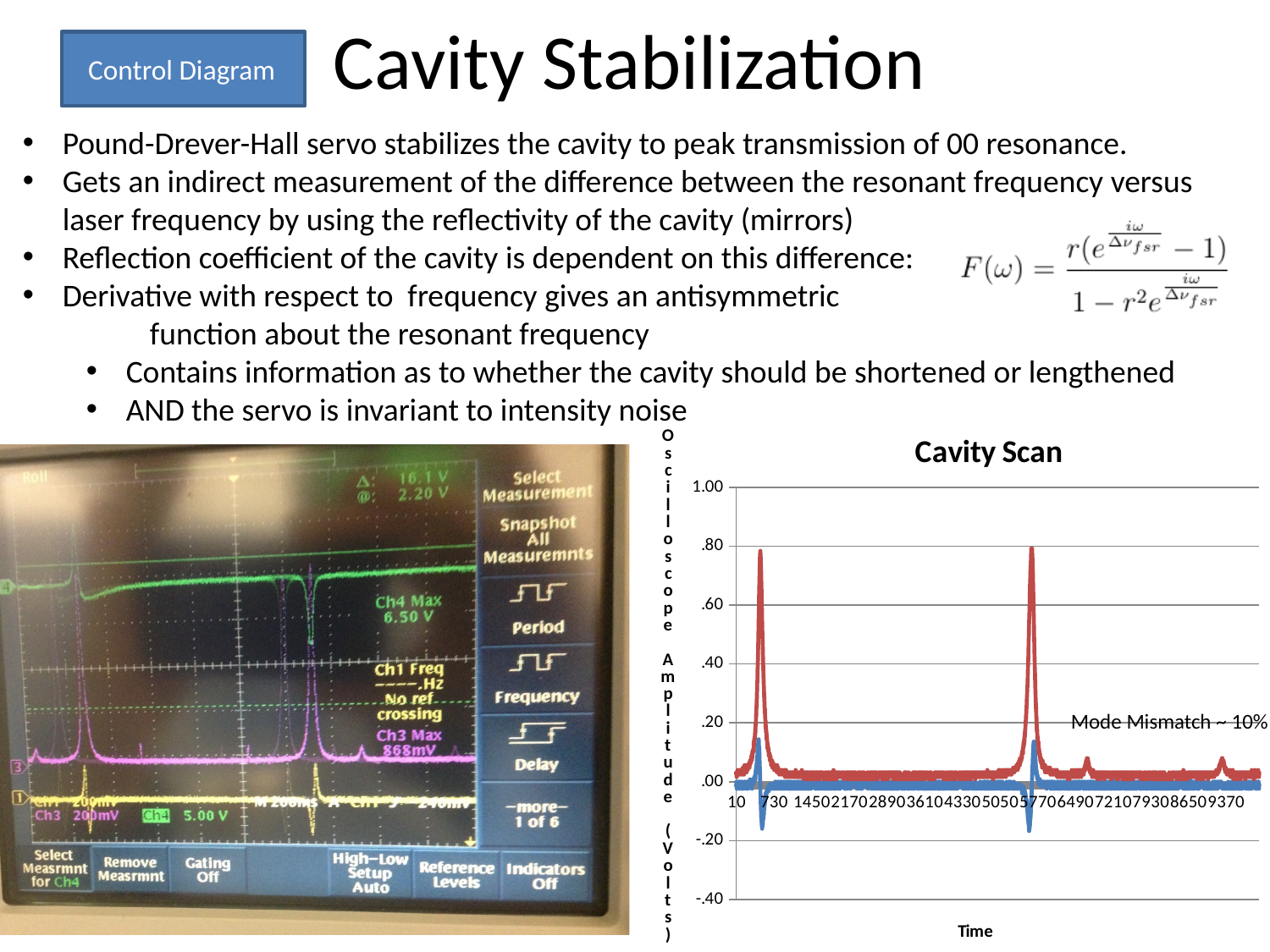
What type of chart is the "Cavity Scan" chart? line chart In the "Cavity Scan" chart, is the highest value reached by the blue line greater or less than .40? less In the "Cavity Scan" chart, is the lowest value reached by the blue line greater or less than .00? less In the "Cavity Scan" chart, what is the label of the x axis? Time How many data series (lines) are plotted in the "Cavity Scan" chart? 2 In the "Cavity Scan" chart, is the highest value reached by the red line greater or less than 1.00? less In the "Cavity Scan" chart, how many peaks of the red line rise above .60? 2 In the "Cavity Scan" chart, which line reaches a higher peak, the red line or the blue line? red line What is the title of the chart on the right side of the slide? Cavity Scan